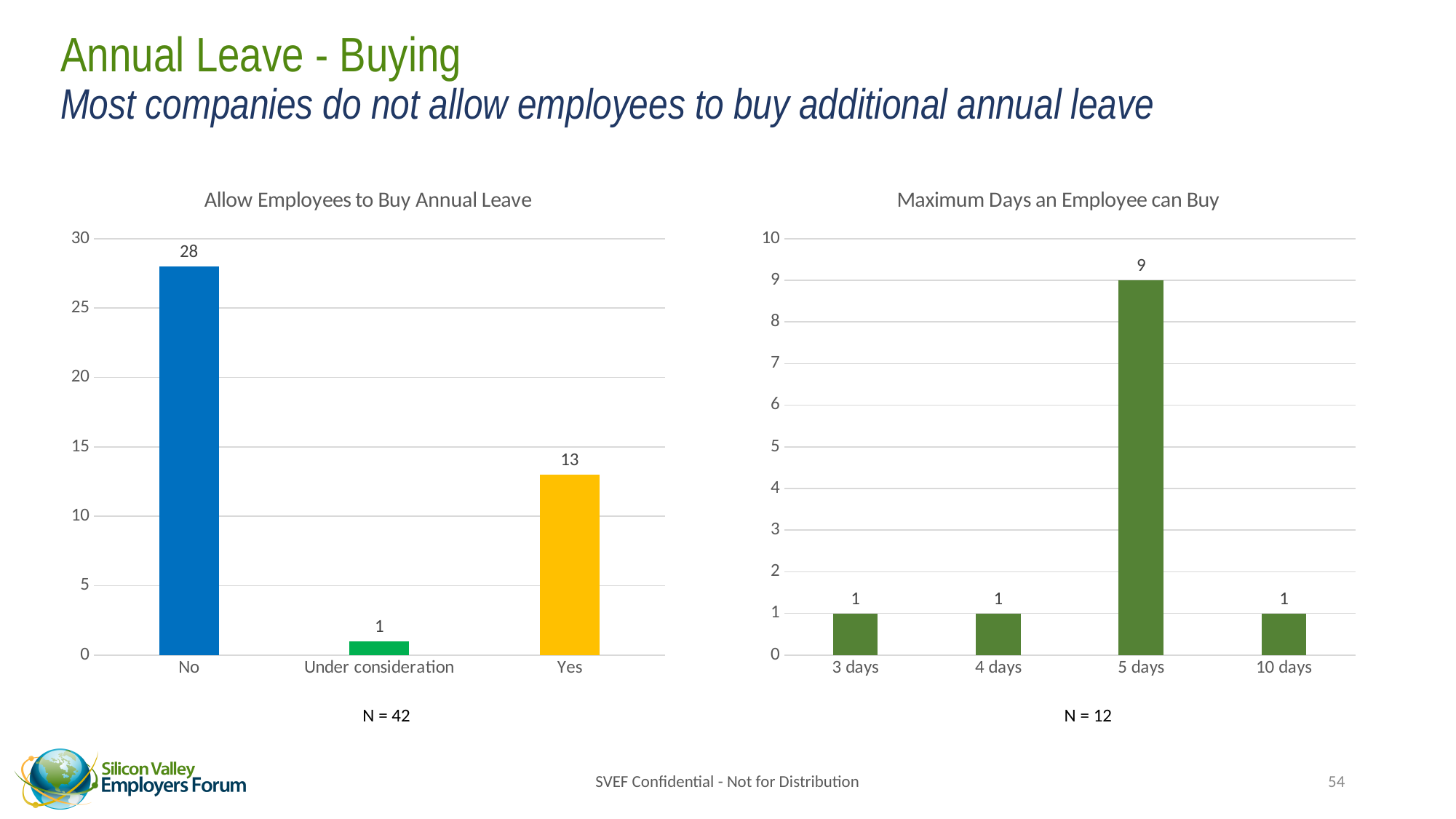
What kind of chart is the 'Allow Employees to Buy Annual Leave' chart? Bar chart What is the title of the chart on the right side of the slide? Maximum Days an Employee can Buy In the 'Allow Employees to Buy Annual Leave' chart, what is the value for 'Yes'? 13 In the 'Maximum Days an Employee can Buy' chart, what is the value for '5 days'? 9 In the 'Allow Employees to Buy Annual Leave' chart, what is the value for 'No'? 28 In the 'Maximum Days an Employee can Buy' chart, what is the value for '10 days'? 1 In the 'Maximum Days an Employee can Buy' chart, is the value for '5 days' greater or less than 8? greater In the 'Maximum Days an Employee can Buy' chart, how many categories are shown on the x axis? 4 In the 'Maximum Days an Employee can Buy' chart, which category has the highest value? 5 days In the 'Allow Employees to Buy Annual Leave' chart, what is the difference between the values for 'No' and 'Yes'? 15 In the 'Allow Employees to Buy Annual Leave' chart, which category has the lowest value? Under consideration In the 'Allow Employees to Buy Annual Leave' chart, how many categories are shown on the x axis? 3